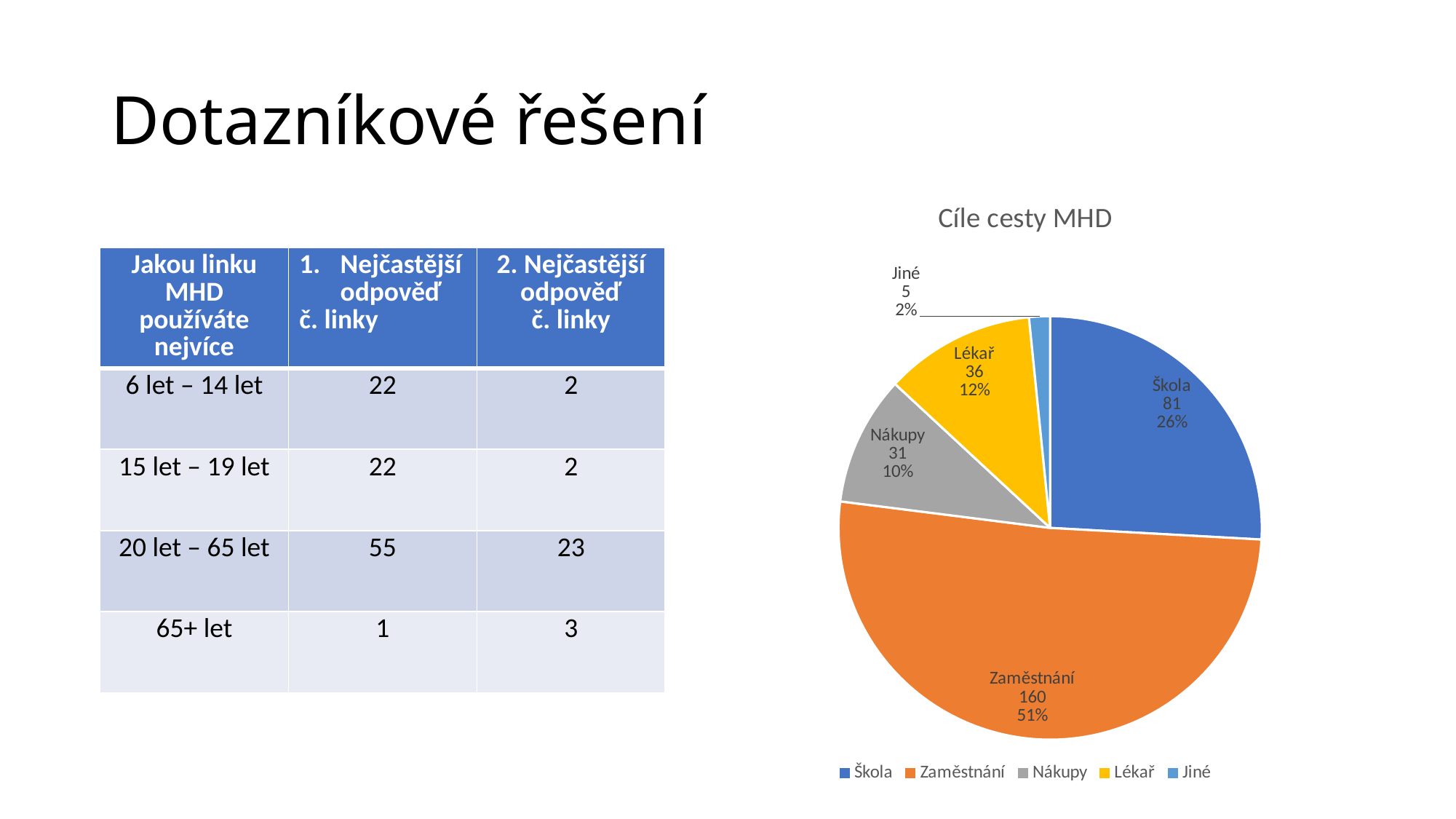
What is the value for Škola in the pie chart? 81 What is the difference between the values for Zaměstnání and Škola? 79 What is the title of the pie chart? Cíle cesty MHD How many categories does the pie chart show? 5 What share of the pie does Škola represent? 26% Which category has the largest slice in the pie chart? Zaměstnání What is the value for Zaměstnání in the pie chart? 160 What share of the pie does Jiné represent? 2% Which is larger, the value for Lékař or the value for Nákupy? Lékař What is the value for Nákupy in the pie chart? 31 What is the value for Lékař in the pie chart? 36 Which category has the smallest slice in the pie chart? Jiné